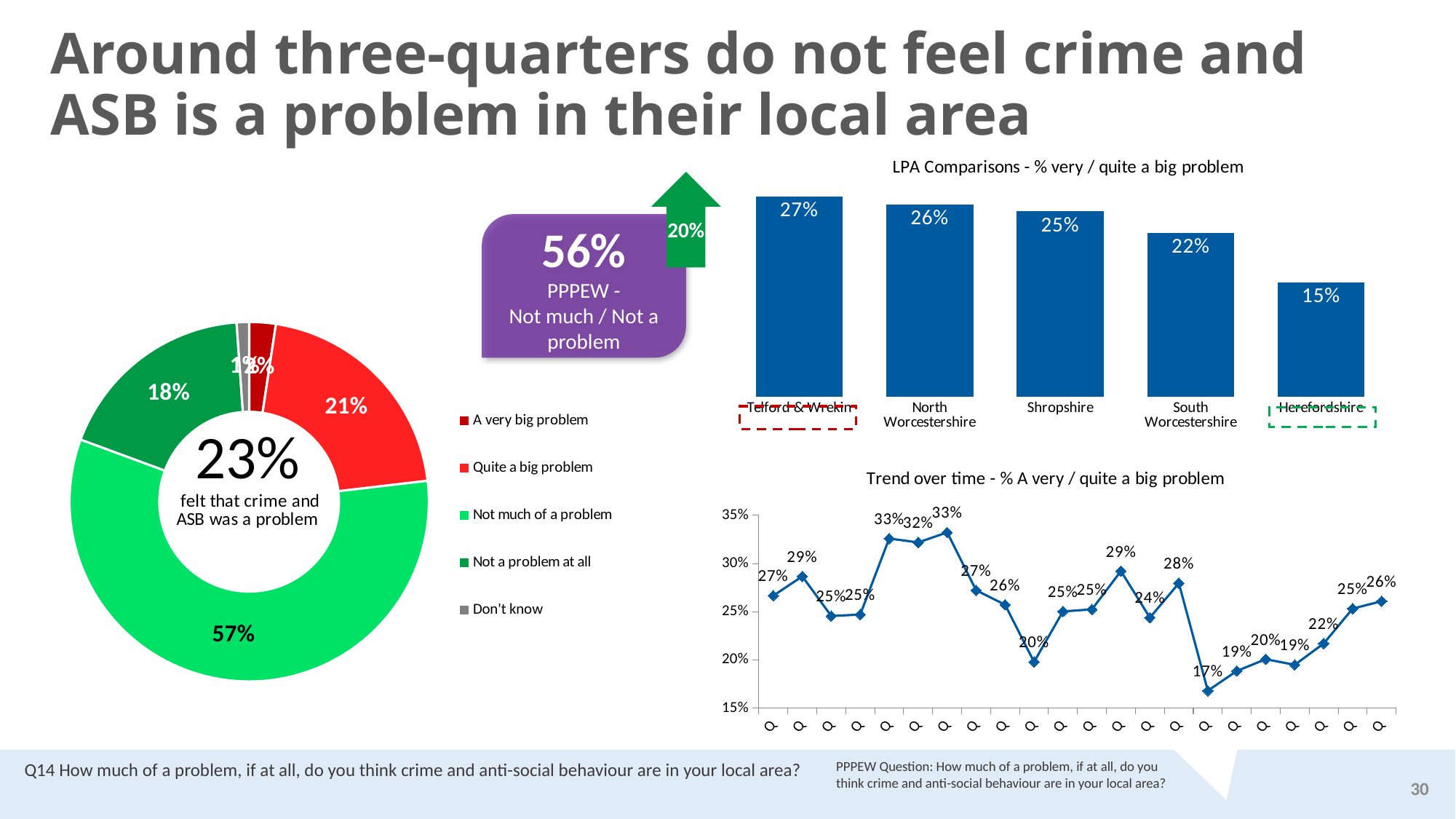
In the Trend over time line chart, what is the lowest value plotted? 17% In the LPA Comparisons bar chart, which area has the lowest value? Herefordshire In the LPA Comparisons bar chart, what is the value for Shropshire? 25% In the LPA Comparisons bar chart, what is the difference between Telford & Wrekin and Herefordshire? 12 percentage points In the LPA Comparisons bar chart, how many areas are shown? 5 In the donut chart on the left, what share of respondents said 'Quite a big problem'? 21% What kind of chart is the LPA Comparisons chart? Bar chart In the donut chart on the left, what share of respondents said 'Not much of a problem'? 57% In the LPA Comparisons bar chart, which area has the highest value? Telford & Wrekin In the donut chart on the left, which is larger: 'Not a problem at all' or 'Quite a big problem'? Quite a big problem In the Trend over time line chart, what is the highest value plotted? 33% How many categories does the legend of the donut chart list? 5